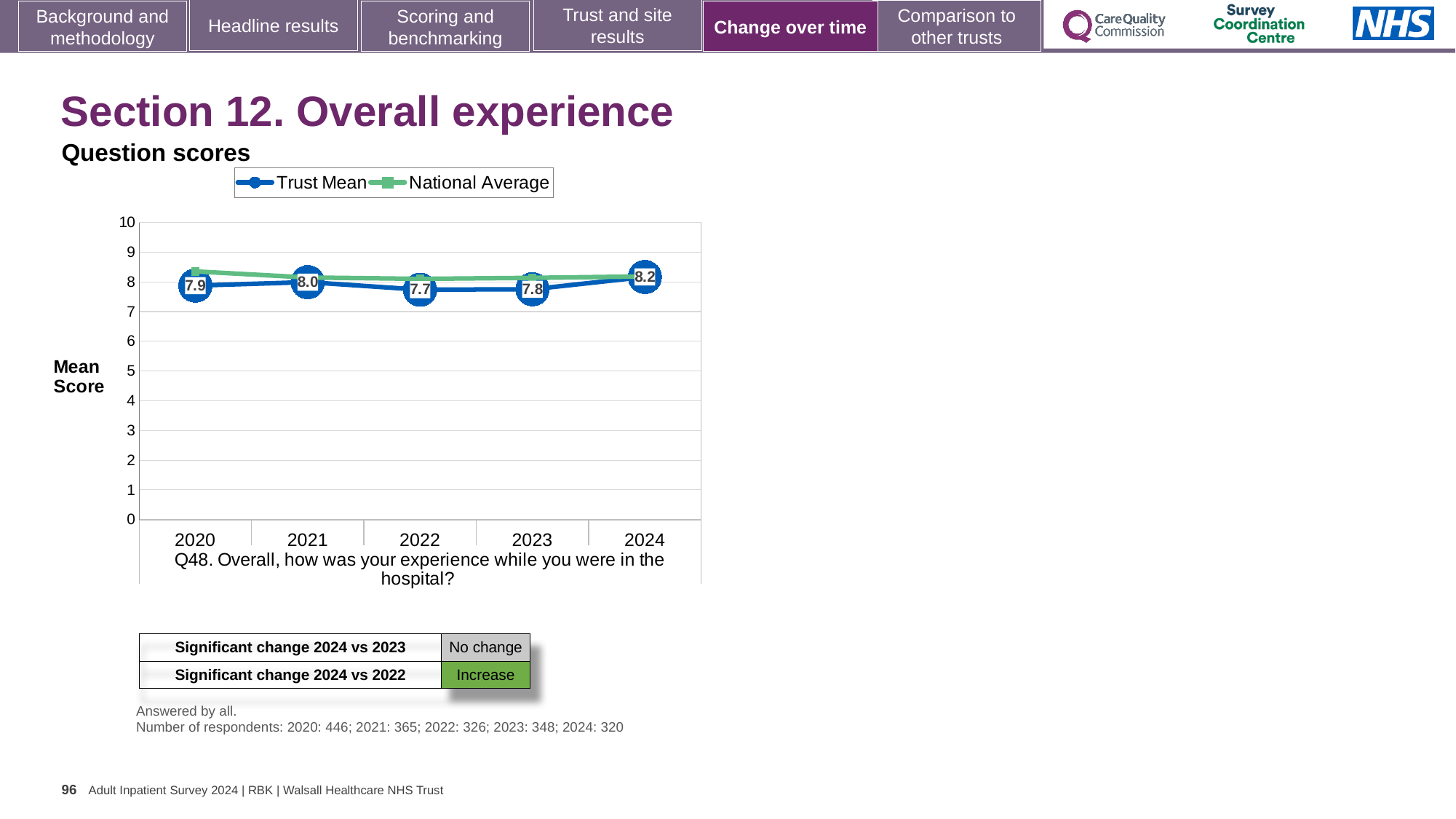
Which year has the larger Trust Mean score, 2021 or 2023? 2021 What is the Trust Mean score for 2024? 8.2 What is the difference between the Trust Mean score in 2024 and in 2022? 0.5 In which year is the Trust Mean score lowest? 2022 How many series does the legend list? 2 What is the Trust Mean score for 2022? 7.7 Is the National Average value for 2020 greater or less than 5? greater How many years are plotted on the x axis? 5 In which year is the Trust Mean score highest? 2024 What kind of chart is shown on the slide? Line chart Does the Trust Mean score rise or fall from 2022 to 2024? Rise What is the Trust Mean score for 2020? 7.9